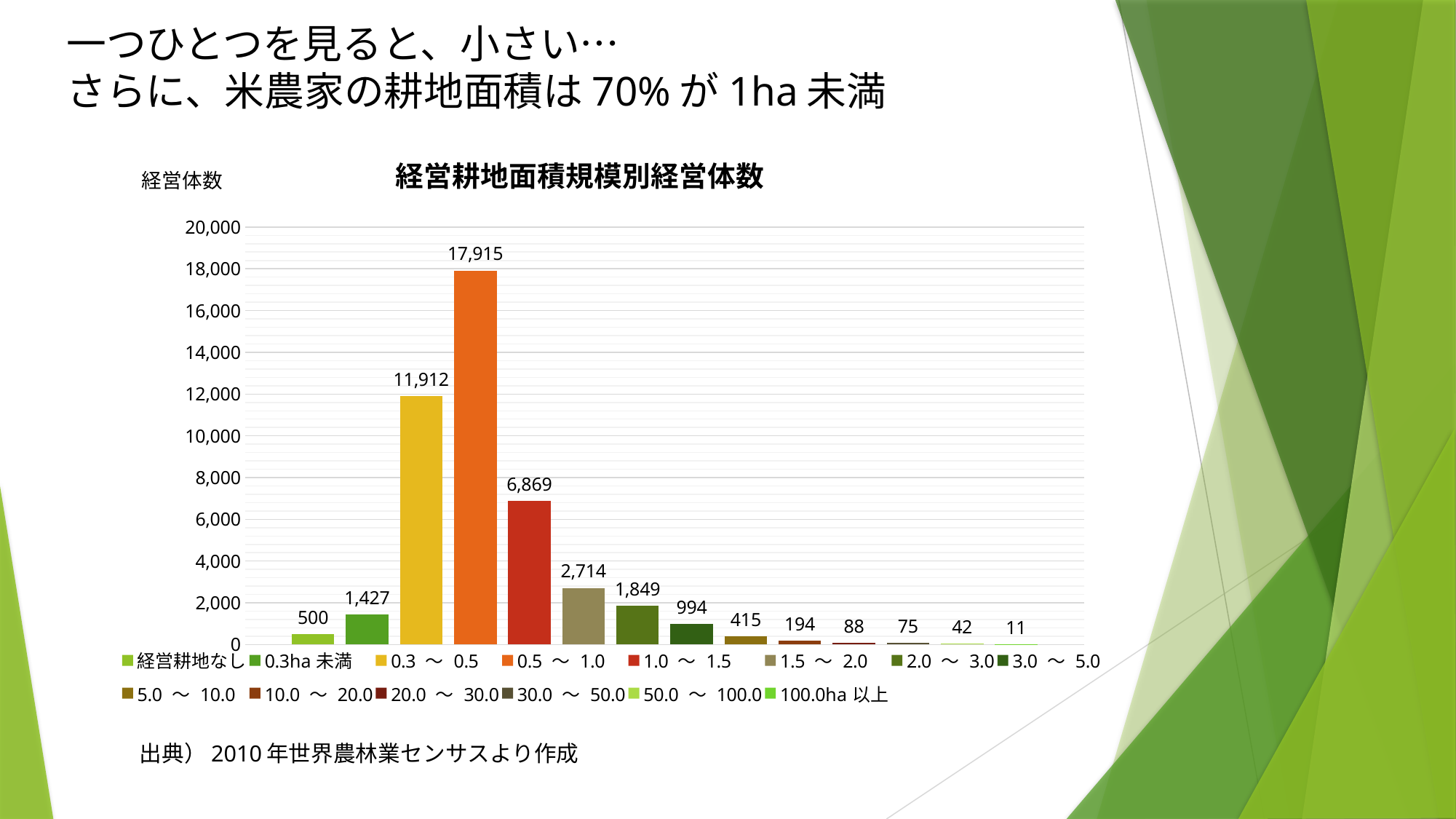
What is the value for 3.0 〜 5.0? 994 Which category has the highest value? 0.5 〜 1.0 What is the difference between the values for 0.5 〜 1.0 and 0.3 〜 0.5? 6,003 Is the value for 1.0 〜 1.5 greater or less than 6,000? greater How many categories does the legend list? 14 What is the value for 経営耕地なし? 500 Which is larger, the value for 1.0 〜 1.5 or the value for 1.5 〜 2.0? 1.0 〜 1.5 What is the value for 0.3 〜 0.5? 11,912 What is the value for 0.5 〜 1.0? 17,915 What type of chart is shown on the slide? bar chart What is the title of the chart? 経営耕地面積規模別経営体数 Which category has the lowest labeled value? 100.0ha 以上